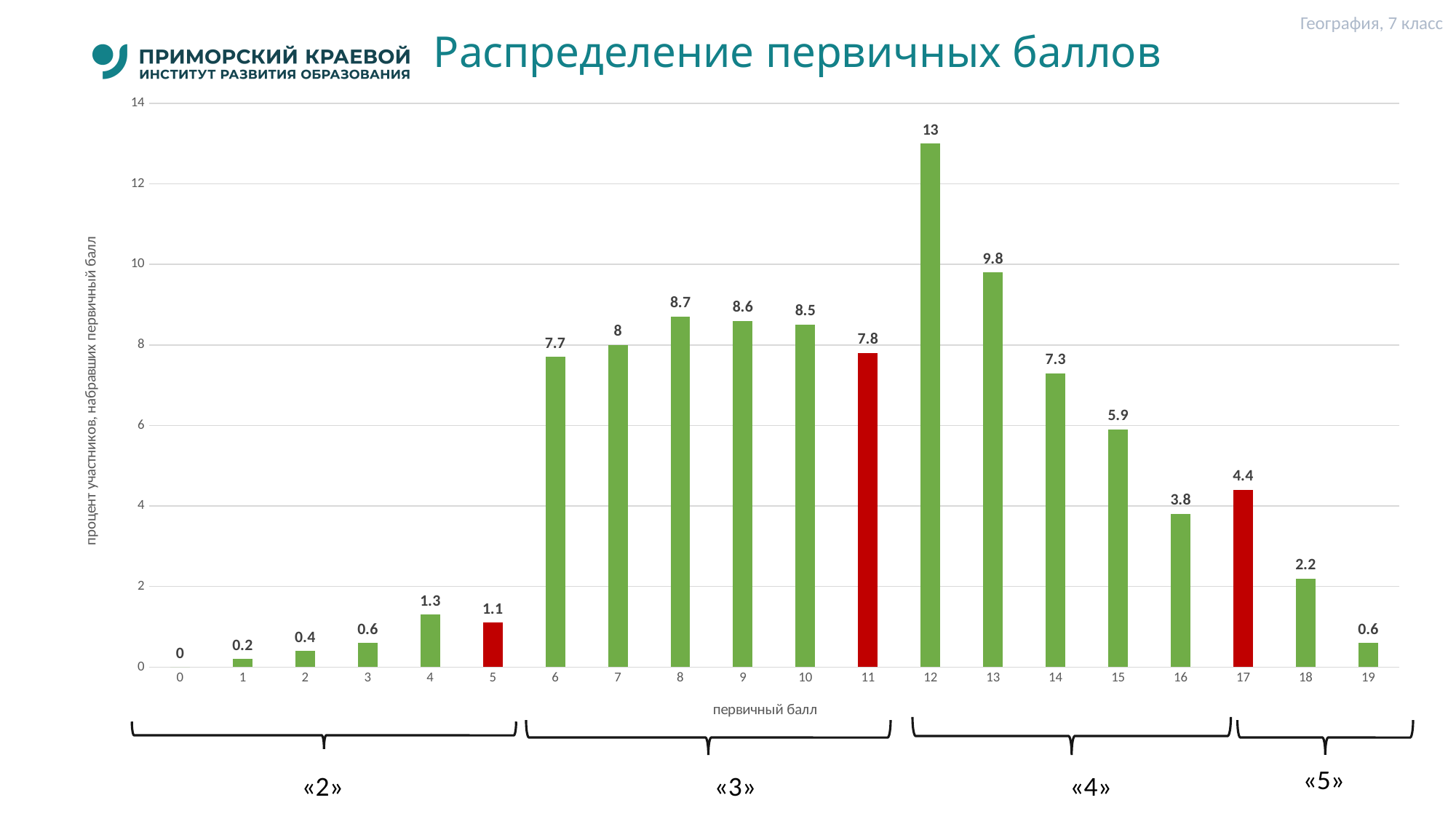
What percentage of participants scored 12 primary points? 13 Which primary score has the highest percentage of participants? 12 Which primary scores are shown with red bars? 5, 11 and 17 How many primary score categories are shown on the x axis? 20 What is the value shown for a primary score of 8? 8.7 What is the difference between the values for primary scores 12 and 13? 3.2 What is the value shown for a primary score of 17? 4.4 What type of chart is shown on the slide? bar chart Is the value for primary score 15 greater or less than 6? less Which has a larger value: primary score 6 or primary score 16? 6 Which primary score has the lowest percentage of participants? 0 Do the values rise or fall from primary score 12 to primary score 16? fall